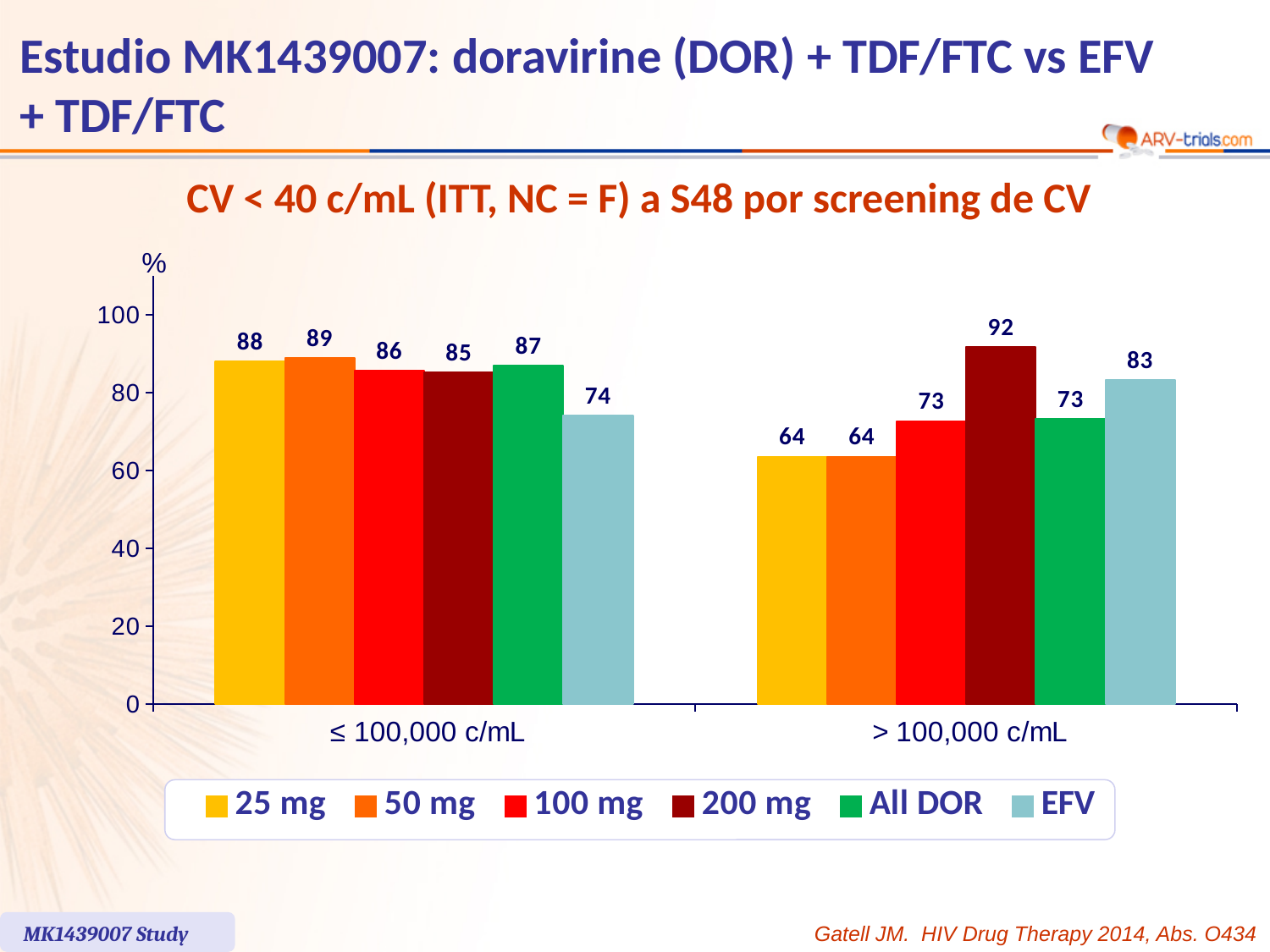
What is the value for 200 mg in the > 100,000 c/mL group? 92 How many categories are shown on the x axis? 2 What is the difference between the 200 mg value and the EFV value in the > 100,000 c/mL group? 9 Which series has the lowest value in the ≤ 100,000 c/mL group? EFV Which series has the highest value in the > 100,000 c/mL group? 200 mg What is the title of the chart? CV < 40 c/mL (ITT, NC = F) a S48 por screening de CV What is the difference between the 50 mg value in the ≤ 100,000 c/mL group and the 50 mg value in the > 100,000 c/mL group? 25 What kind of chart is shown on the slide? Bar chart How many series does the legend list? 6 What is the value for 25 mg in the ≤ 100,000 c/mL group? 88 What is the value for EFV in the > 100,000 c/mL group? 83 Which is larger in the ≤ 100,000 c/mL group: the All DOR value or the EFV value? All DOR